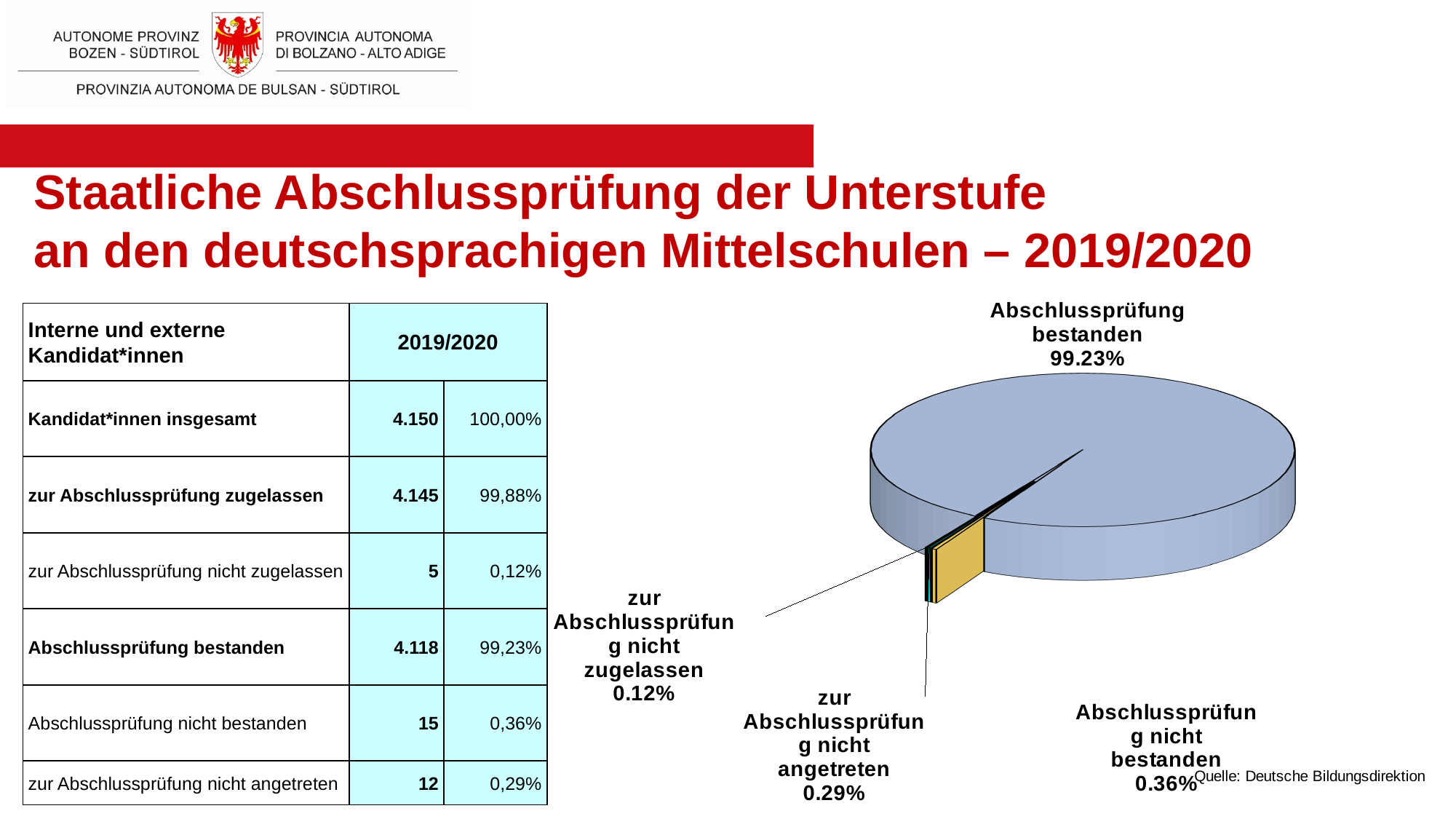
Which is larger in the pie chart: "Abschlussprüfung nicht bestanden" or "zur Abschlussprüfung nicht angetreten"? Abschlussprüfung nicht bestanden What is the difference between the shares for "zur Abschlussprüfung nicht angetreten" and "zur Abschlussprüfung nicht zugelassen" in the pie chart? 0.17% Which slice of the pie chart is the smallest? zur Abschlussprüfung nicht zugelassen Which slice of the pie chart is the largest? Abschlussprüfung bestanden How many slices does the pie chart have? 4 What share of the pie is labelled "zur Abschlussprüfung nicht zugelassen"? 0.12% What is the difference between the shares for "Abschlussprüfung nicht bestanden" and "zur Abschlussprüfung nicht zugelassen" in the pie chart? 0.24% What share of the pie is labelled "Abschlussprüfung bestanden"? 99.23% What share of the pie is labelled "zur Abschlussprüfung nicht angetreten"? 0.29% What colour is the largest slice of the pie chart? light blue What kind of chart is shown on the slide? pie chart